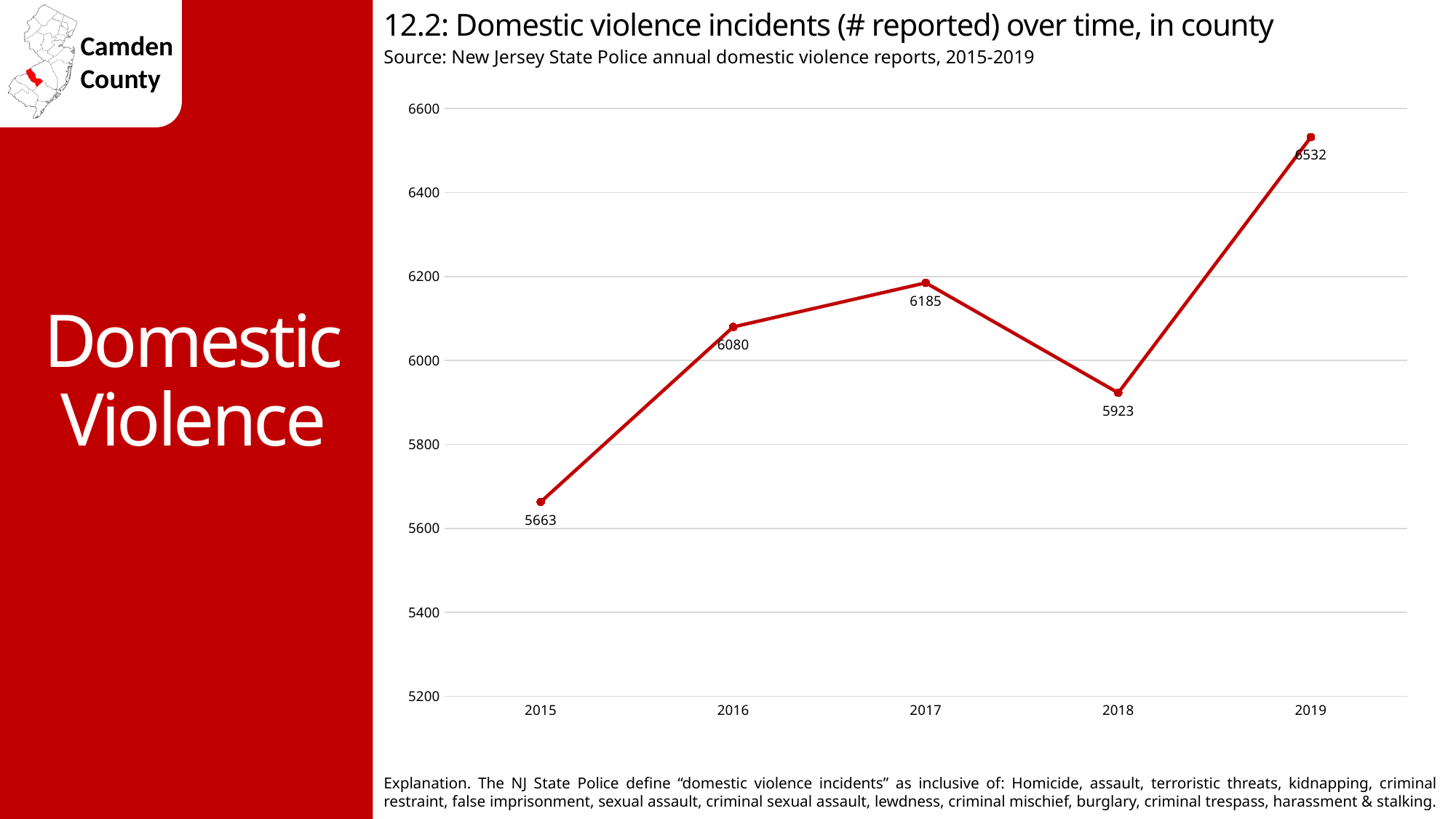
By how much did reported incidents increase from 2015 to 2016? 417 Which year had more reported incidents, 2016 or 2018? 2016 What is the number of reported domestic violence incidents for 2017? 6185 Which year has the lowest number of reported domestic violence incidents? 2015 Is the value for 2018 greater or less than 6000? less What value is shown for 2019? 6532 How many years are plotted on the chart? 5 What is the difference between the 2019 and 2018 values? 609 Which year has the highest number of reported domestic violence incidents? 2019 How many domestic violence incidents were reported in 2015? 5663 Did the number of reported incidents rise or fall from 2017 to 2018? fall What kind of chart is shown on the slide? line chart